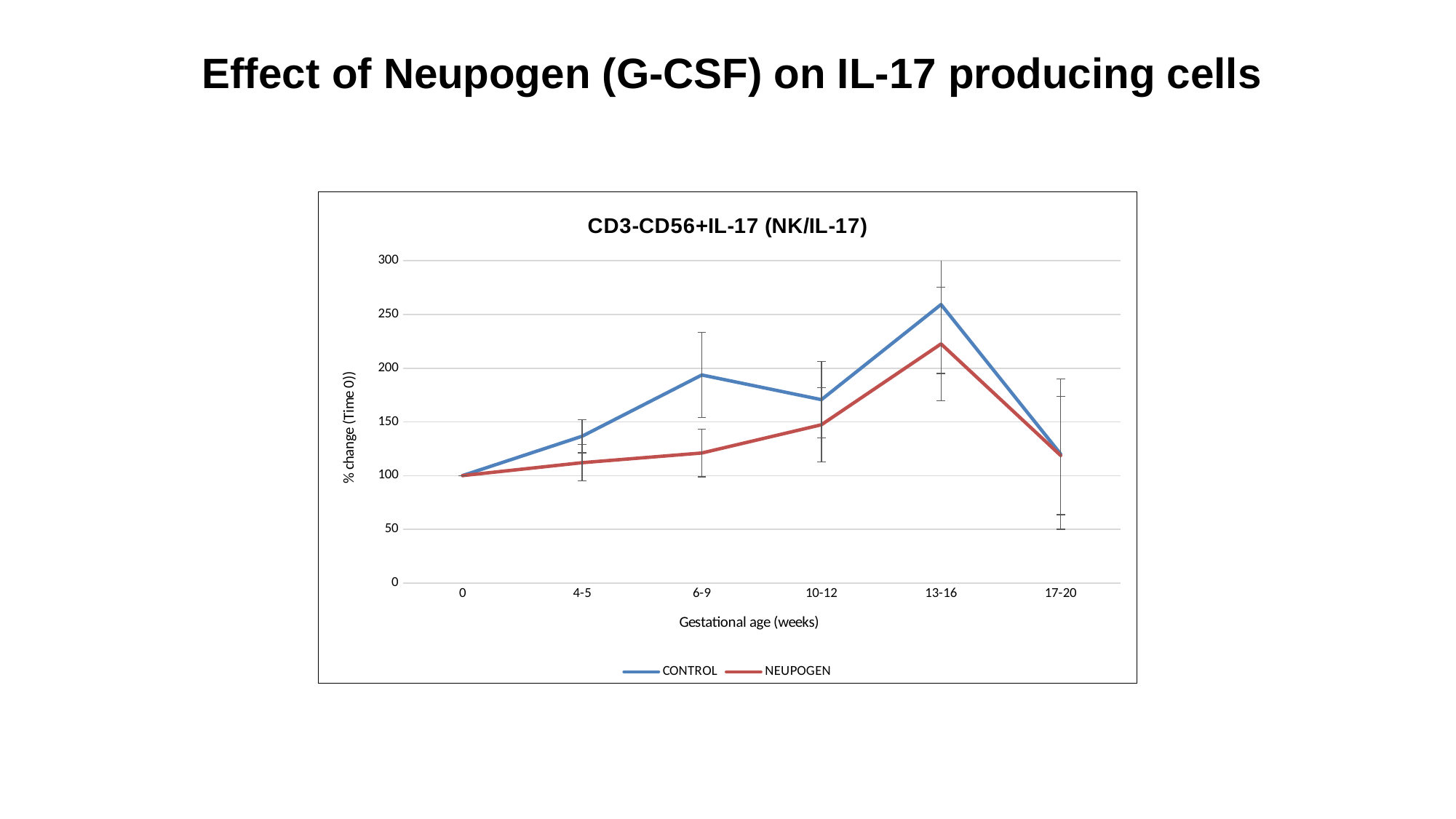
Does the CONTROL series rise or fall from 13-16 weeks to 17-20 weeks? Fall How many gestational age categories are shown on the x axis? 6 Is the value for NEUPOGEN at 6-9 weeks greater or less than 150? less Is the value for NEUPOGEN at 13-16 weeks greater or less than 200? greater At which gestational age does the CONTROL series reach its highest value? 13-16 What is the value for CONTROL at gestational age 0? 100 At which gestational age does the NEUPOGEN series reach its highest value? 13-16 How many series does the legend list? 2 At 6-9 weeks, which series has the larger value, CONTROL or NEUPOGEN? CONTROL What kind of chart is shown on the slide? Line chart Is the value for CONTROL at 6-9 weeks greater or less than 150? greater What is the title of the chart? CD3-CD56+IL-17 (NK/IL-17)